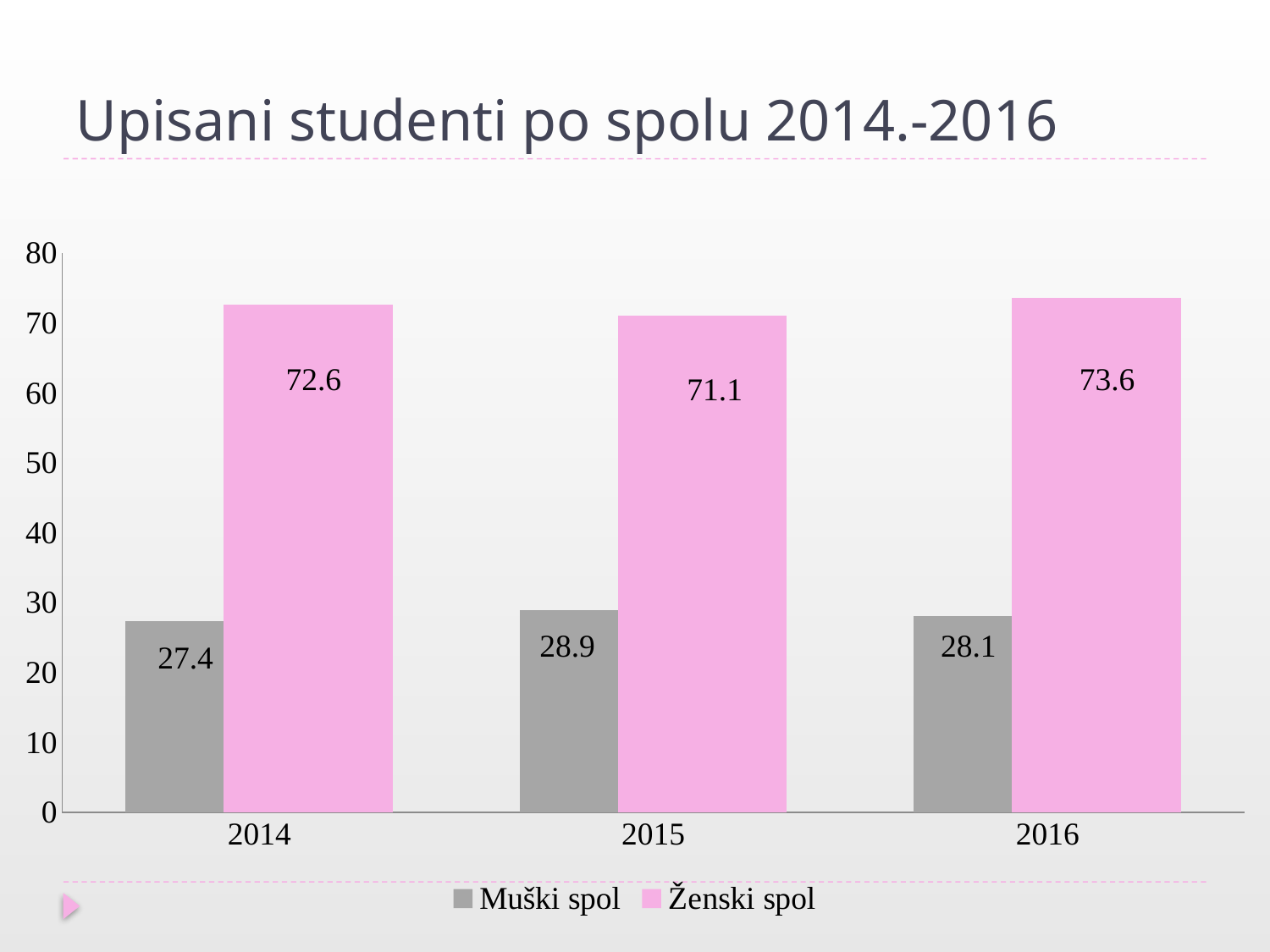
What is the title of the chart? Upisani studenti po spolu 2014.-2016 Is the value for Ženski spol in 2015 greater or less than 60? greater What is the value for Muški spol in 2015? 28.9 How many years are shown on the x axis? 3 What is the difference between Ženski spol and Muški spol in 2015? 42.2 What is the value for Ženski spol in 2014? 72.6 In which year is the value for Muški spol lowest? 2014 What kind of chart is shown on the slide? bar chart What is the value for Muški spol in 2016? 28.1 How many series does the legend list? 2 Which is larger in 2016, Muški spol or Ženski spol? Ženski spol In which year is the value for Ženski spol highest? 2016